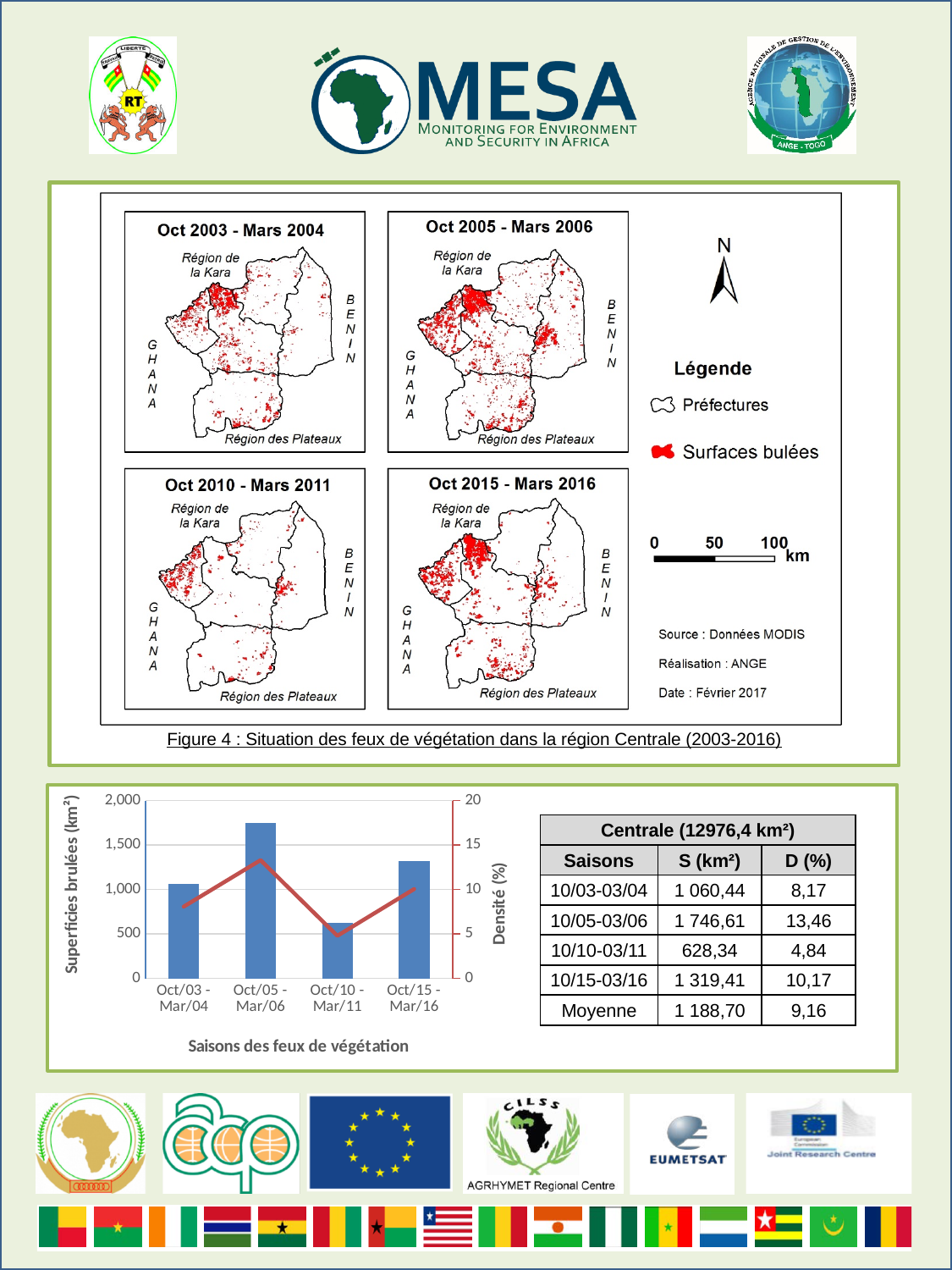
Which season has the shortest bar for Superficies brulées (km²)? Oct/10 - Mar/11 What is the title of the x axis of the chart? Saisons des feux de végétation Is the burned area bar for Oct/10 - Mar/11 greater or less than 1,000 km²? less What is the label of the right-hand vertical axis of the chart? Densité (%) Which season has the tallest bar for Superficies brulées (km²)? Oct/05 - Mar/06 At which season does the Densité (%) line reach its highest point? Oct/05 - Mar/06 Does the Densité (%) line rise or fall from Oct/05 - Mar/06 to Oct/10 - Mar/11? fall How many fire seasons are plotted on the x axis of the chart? 4 Is the Densité (%) value for Oct/10 - Mar/11 greater or less than 10? less Which bar is taller: Oct/15 - Mar/16 or Oct/03 - Mar/04? Oct/15 - Mar/16 What kind of chart is shown at the bottom of the slide? A bar chart combined with a line Is the burned area bar for Oct/05 - Mar/06 greater or less than 1,500 km²? greater